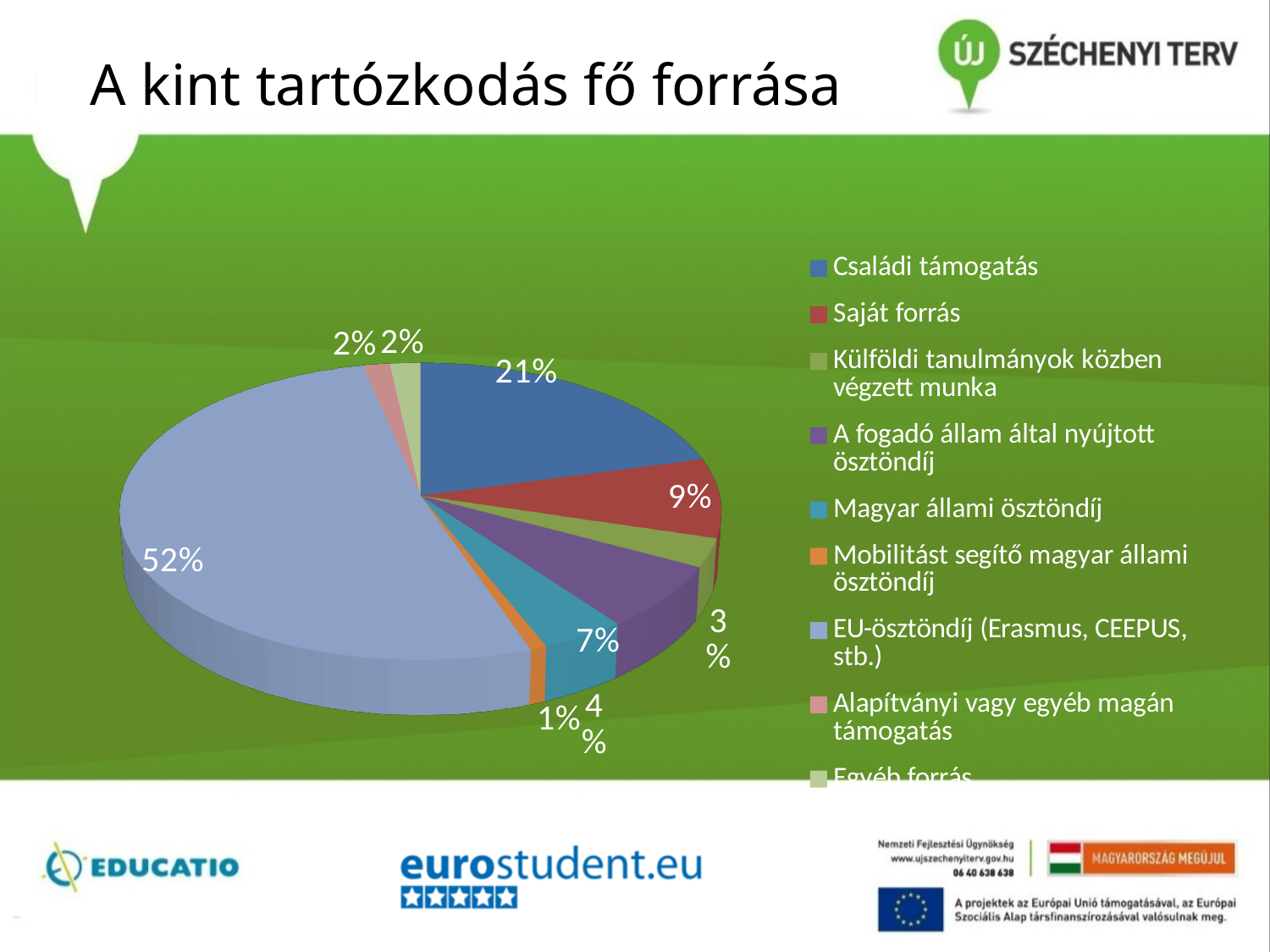
How many categories does the legend list? 9 What kind of chart is shown on the slide? pie chart Which is larger, the share for Saját forrás or the share for A fogadó állam által nyújtott ösztöndíj? Saját forrás Which category has the smallest share of the pie? Mobilitást segítő magyar állami ösztöndíj What is the difference between the shares of Családi támogatás and Saját forrás? 12% What is the value for Családi támogatás? 21% What is the value for Saját forrás? 9% What is the title of the slide? A kint tartózkodás fő forrása What share of the pie does EU-ösztöndíj (Erasmus, CEEPUS, stb.) have? 52% Which category has the largest share of the pie? EU-ösztöndíj (Erasmus, CEEPUS, stb.) What is the value for A fogadó állam által nyújtott ösztöndíj? 7% What is the value for Magyar állami ösztöndíj? 4%